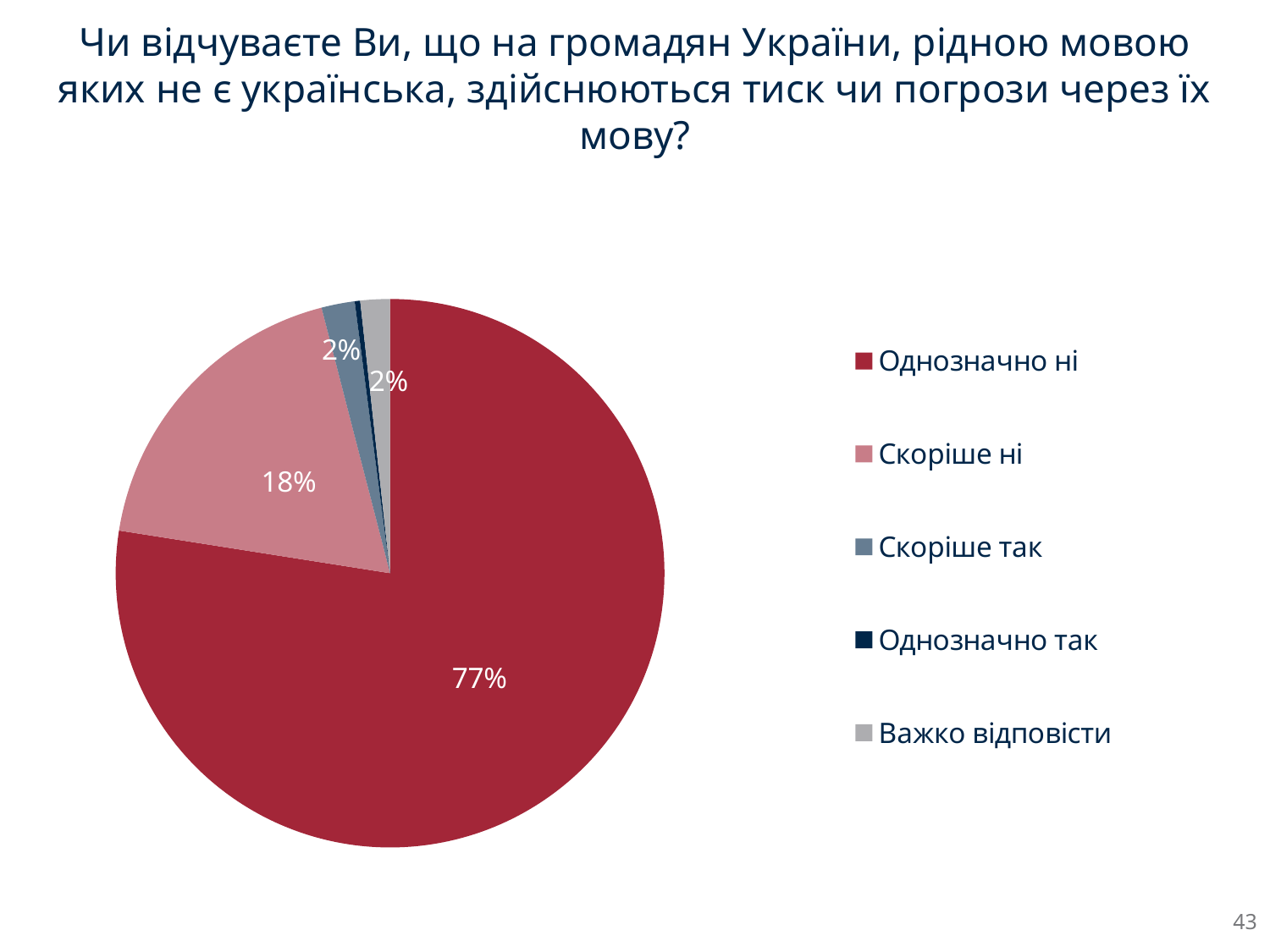
Which answer option has the largest slice of the pie? Однозначно ні How many answer options does the legend list? 5 What share of respondents answered "Скоріше так"? 2% Which answer option has the smallest slice of the pie? Однозначно так What share of respondents answered "Важко відповісти"? 2% Which is larger: the share for "Скоріше ні" or the share for "Скоріше так"? Скоріше ні What is the difference in percentage points between "Однозначно ні" and "Скоріше ні"? 59 What type of chart is shown on the slide? pie chart What colour is the slice for "Однозначно ні"? dark red What is the combined share of "Однозначно ні" and "Скоріше ні"? 95% What share of respondents answered "Однозначно ні"? 77% What share of respondents answered "Скоріше ні"? 18%